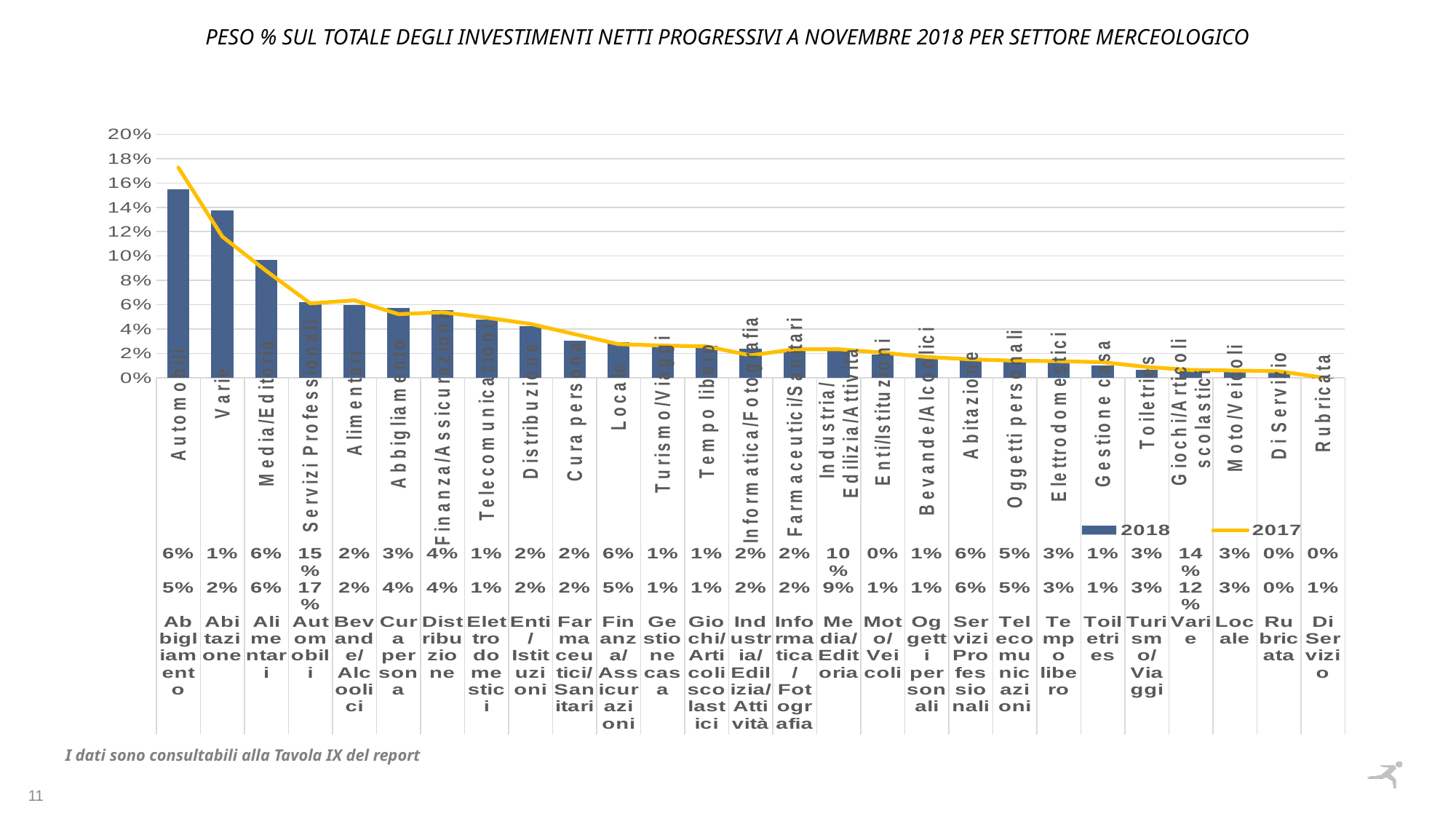
Is the 2017 line value for Automobili greater or less than 16%? greater Is the 2018 bar for Media/Editoria greater or less than 10%? less Is the 2018 bar for Automobili greater or less than 14%? greater What kind of chart is shown on the slide? bar chart with a line Which has the larger 2018 bar, Distribuzione or Cura persona? Distribuzione How many series does the legend list? 2 Which sector has the highest 2018 bar? Automobili Do the 2018 bars rise or fall from left to right along the x axis? fall How many sectors are plotted on the x axis? 27 Which series is drawn as a yellow line? 2017